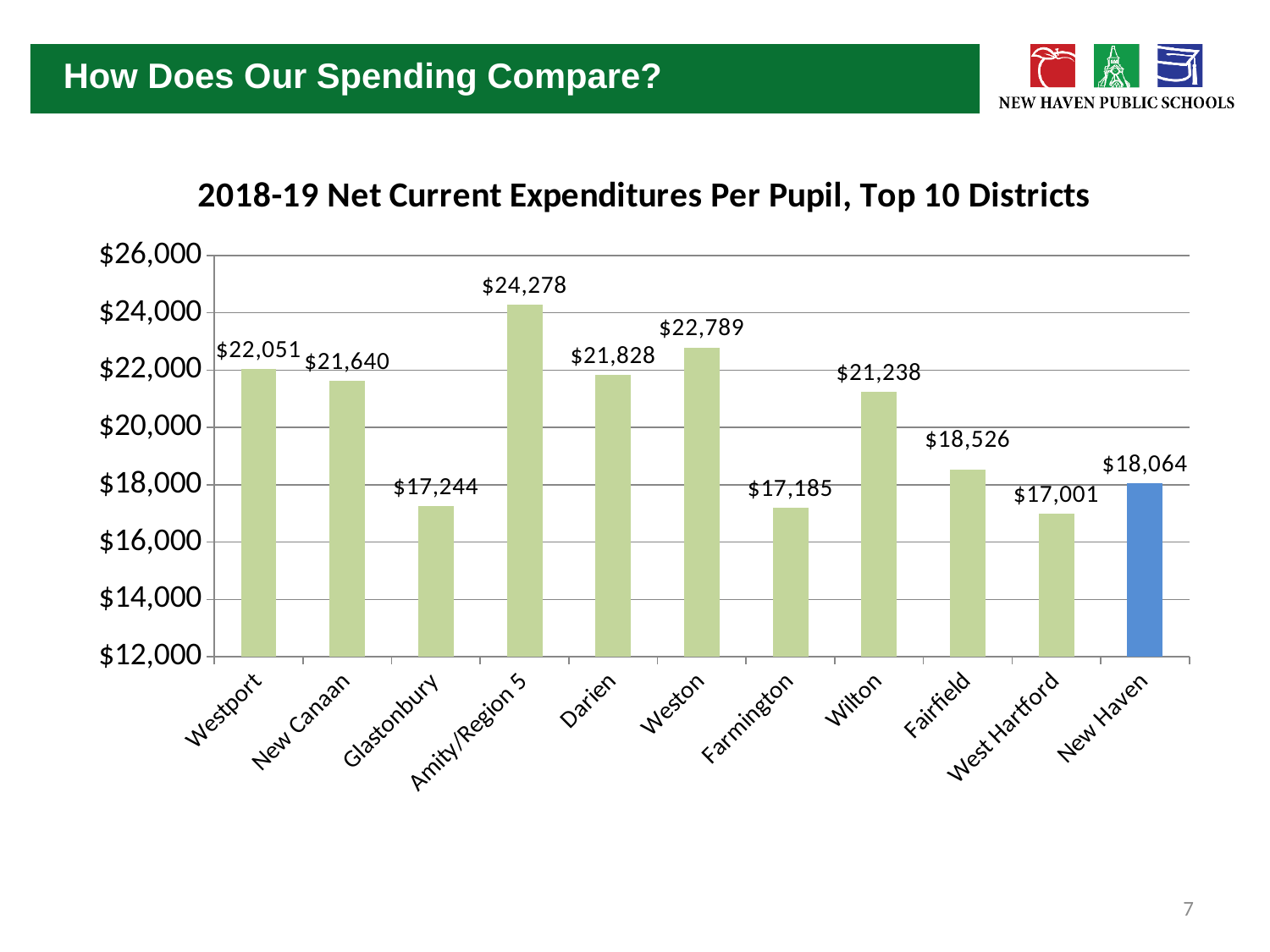
What is the value shown for Wilton? $21,238 What kind of chart is shown on the slide? bar chart Which has a higher value, Fairfield or New Haven? Fairfield Is the value for Glastonbury greater or less than $18,000? less What is the difference between the values for Weston and Darien? $961 What is the net current expenditure per pupil for Amity/Region 5? $24,278 Which district's bar is coloured blue instead of green? New Haven Which district has the lowest net current expenditure per pupil? West Hartford What is the net current expenditure per pupil for New Haven? $18,064 What is the difference between the values for Westport and New Haven? $3,987 Which district has the highest net current expenditure per pupil? Amity/Region 5 How many districts are shown on the chart? 11